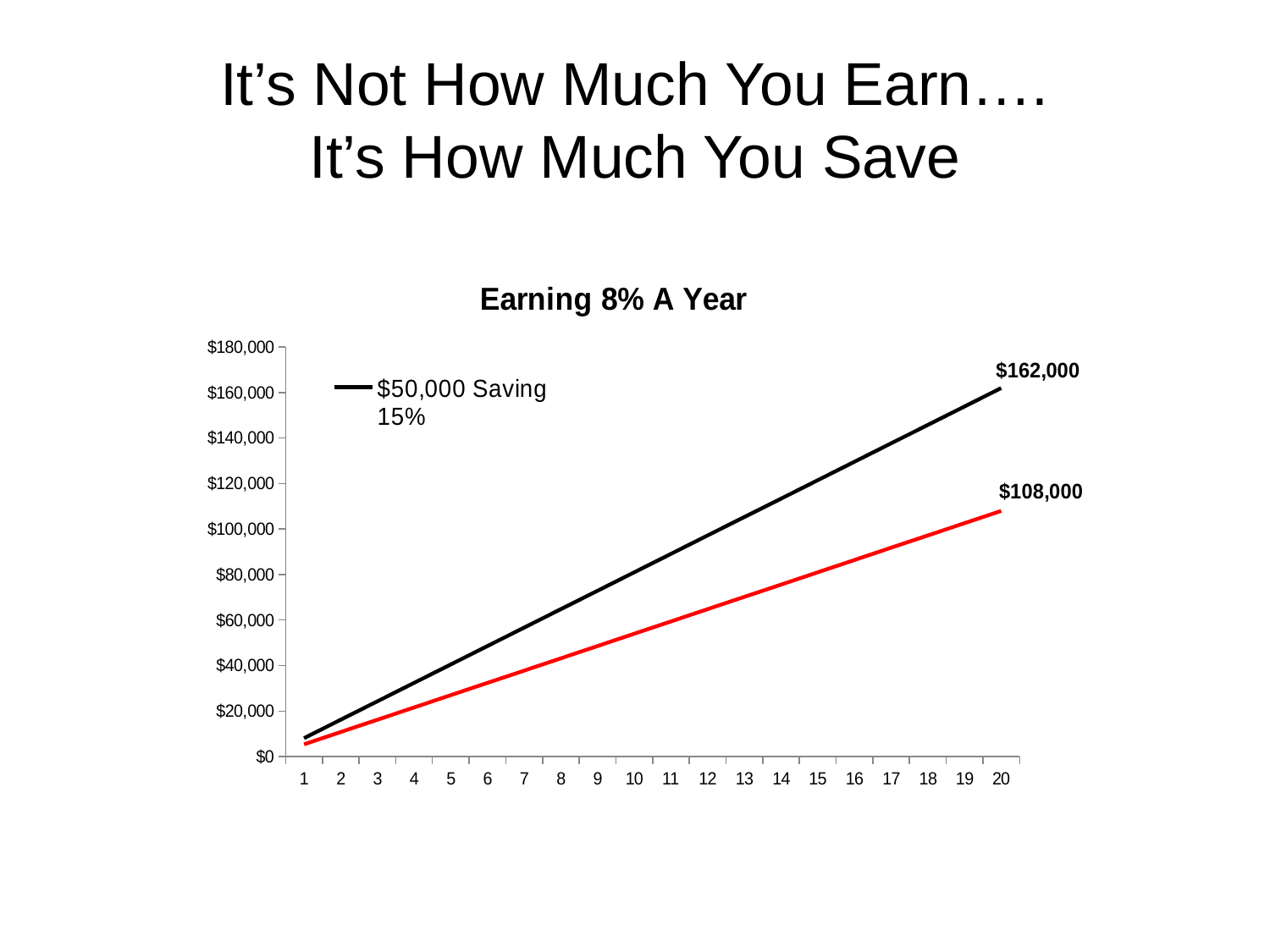
What is the difference between the black line's value and the red line's value at year 20? $54,000 What kind of chart is shown on the slide? line chart Which line is higher at year 20, the black line or the red line? the black line How many years are shown along the x axis? 20 Is the value of the black line at year 10 greater or less than $60,000? greater Is the value of the red line at year 10 greater or less than $80,000? less Do the lines rise or fall as the years increase along the x axis? rise What value does the red line reach at year 20? $108,000 What value does the black line reach at year 20? $162,000 How many entries does the legend list? 1 What is the legend entry shown for the black line? $50,000 Saving 15% What is the title of the chart? Earning 8% A Year